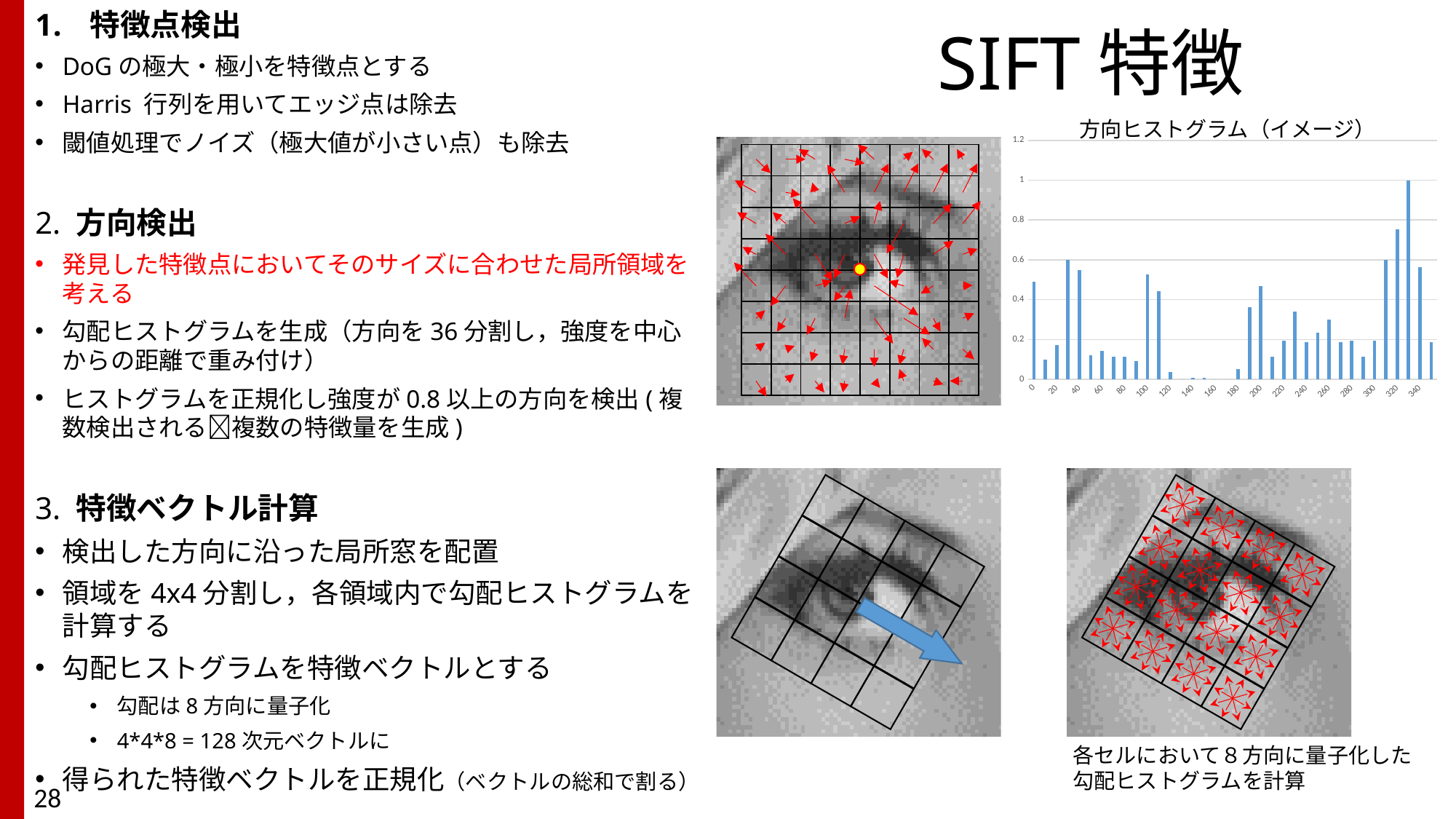
Is the value for 200 greater or less than 0.6? less Which has the larger value, 100 or 120? 100 Is the value for 0 greater or less than 0.4? greater Which x-axis category has the tallest bar in the 方向ヒストグラム（イメージ） chart? 330 What is the title of the chart on the slide? 方向ヒストグラム（イメージ） Is the value for 160 greater or less than 0.2? less What is the highest tick label shown on the y-axis of the chart? 1.2 What kind of chart is the 方向ヒストグラム（イメージ） chart? bar chart Which has the larger value, 320 or 340? 320